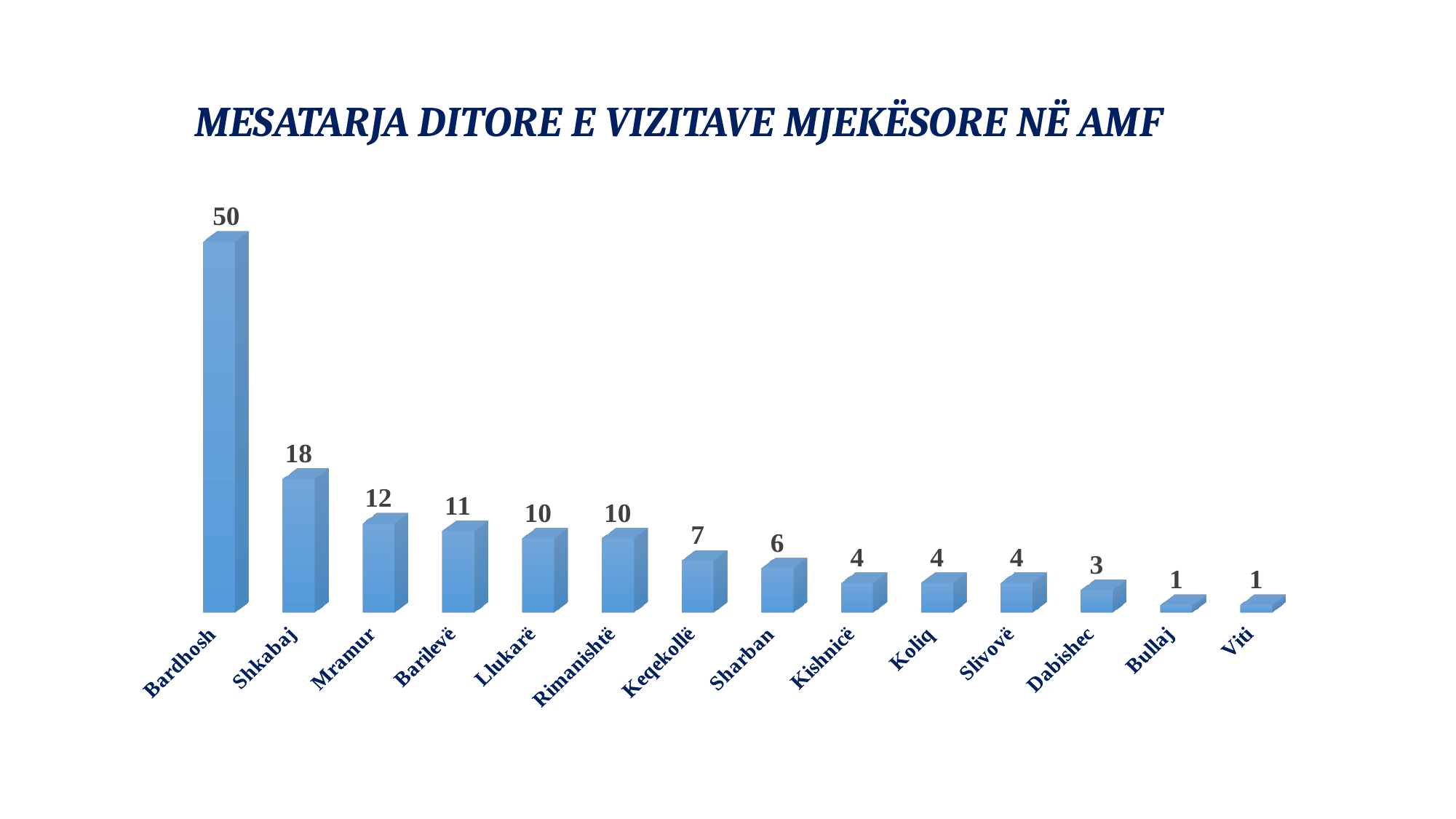
What is the value for Bardhosh? 50 What is the value for Shkabaj? 18 What is the value for Keqekollë? 7 What is the difference between the values for Mramur and Sharban? 6 How many categories are shown on the chart? 14 What is the title of the chart? MESATARJA DITORE E VIZITAVE MJEKËSORE NË AMF What is the value for Dabishec? 3 What is the difference between the values for Bardhosh and Shkabaj? 32 Do the values rise or fall from left to right along the x axis? fall Which category has the highest value? Bardhosh Which is larger, the value for Barilevë or the value for Kishnicë? Barilevë What kind of chart is shown on the slide? bar chart